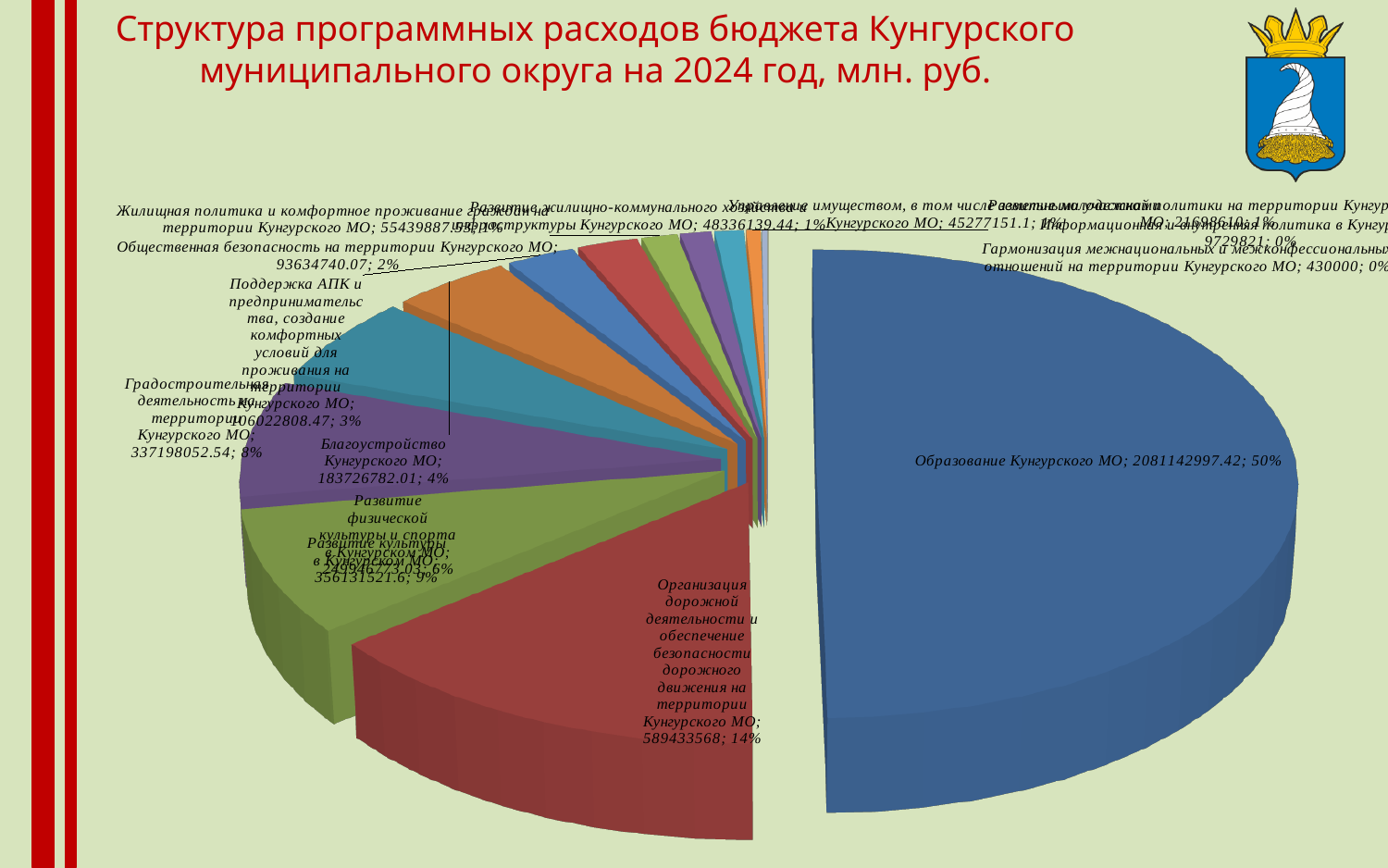
What is the title of the chart on the slide? Структура программных расходов бюджета Кунгурского муниципального округа на 2024 год, млн. руб. What share of the pie does Образование Кунгурского МО account for? 50% What is the value shown for Благоустройство Кунгурского МО? 183726782.01 Which category has the smallest value in the pie? Гармонизация межнациональных и межконфессиональных отношений на территории Кунгурского МО Which category has the largest share of the pie? Образование Кунгурского МО What kind of chart is shown on the slide? Pie chart What is the value shown for Организация дорожной деятельности и обеспечение безопасности дорожного движения на территории Кунгурского МО? 589433568 What share of the pie does Градостроительная деятельность на территории Кунгурского МО account for? 8% What is the value shown for Образование Кунгурского МО? 2081142997.42 What is the value shown for Общественная безопасность на территории Кунгурского МО? 93634740.07 By how many percentage points does the share of Образование Кунгурского МО exceed the share of Организация дорожной деятельности и обеспечение безопасности дорожного движения на территории Кунгурского МО? 36 percentage points Which is larger: the value for Благоустройство Кунгурского МО or the value for Общественная безопасность на территории Кунгурского МО? Благоустройство Кунгурского МО